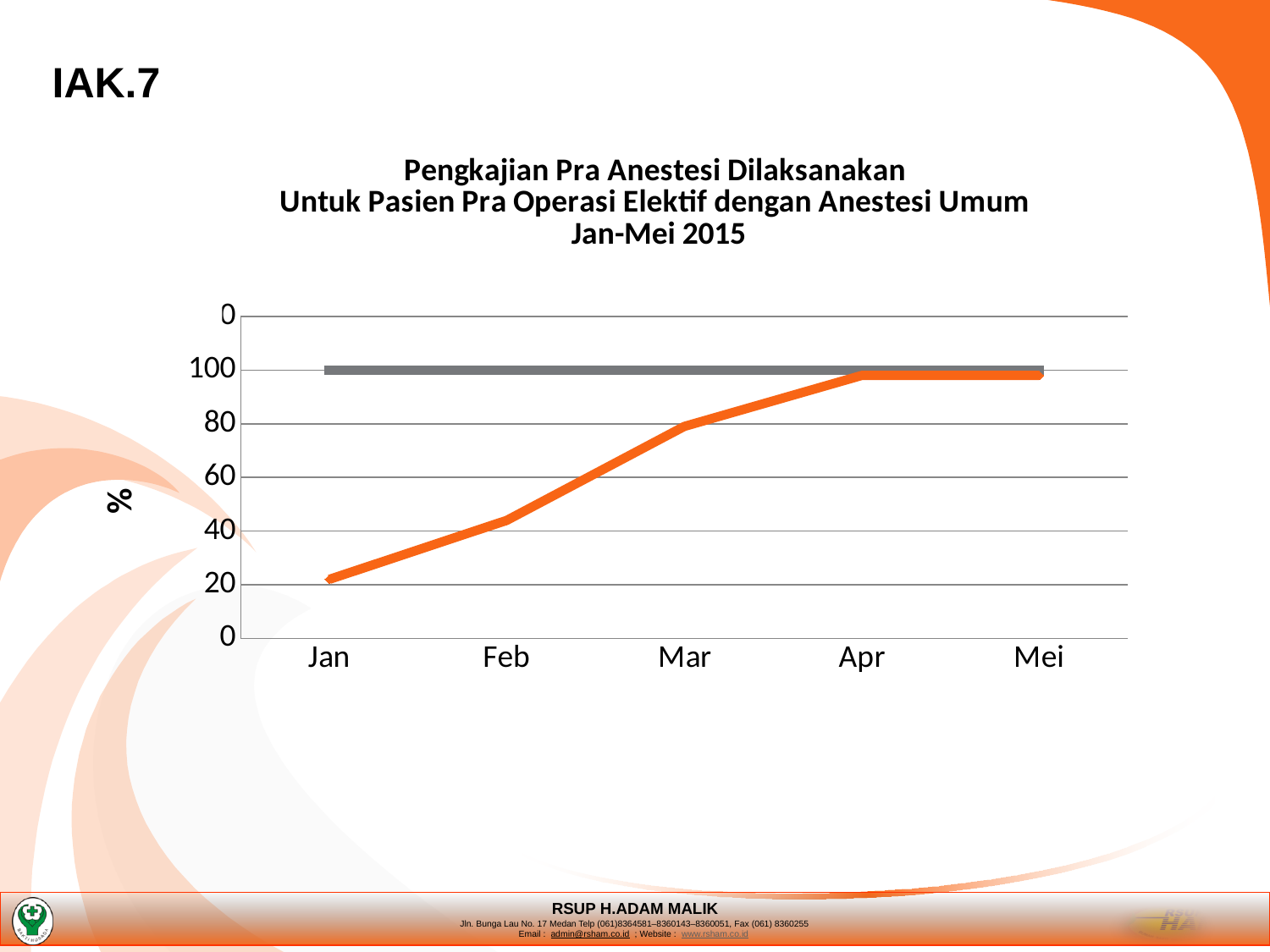
What kind of chart is shown on the slide? line chart What period does the chart title say the data covers? Jan-Mei 2015 Is the value for Mar on the orange line greater or less than 60? greater Which month has the lowest value on the orange line? Jan Is the value for Jan on the orange line greater or less than 40? less Does the orange line rise or fall from Jan to Apr? rise Which is larger on the orange line, the value for Jan or the value for Mar? Mar What is the label on the y axis of the chart? % Is the value for Apr on the orange line greater or less than 80? greater How many months are shown on the x axis of the chart? 5 Which is larger on the orange line, the value for Feb or the value for Apr? Apr